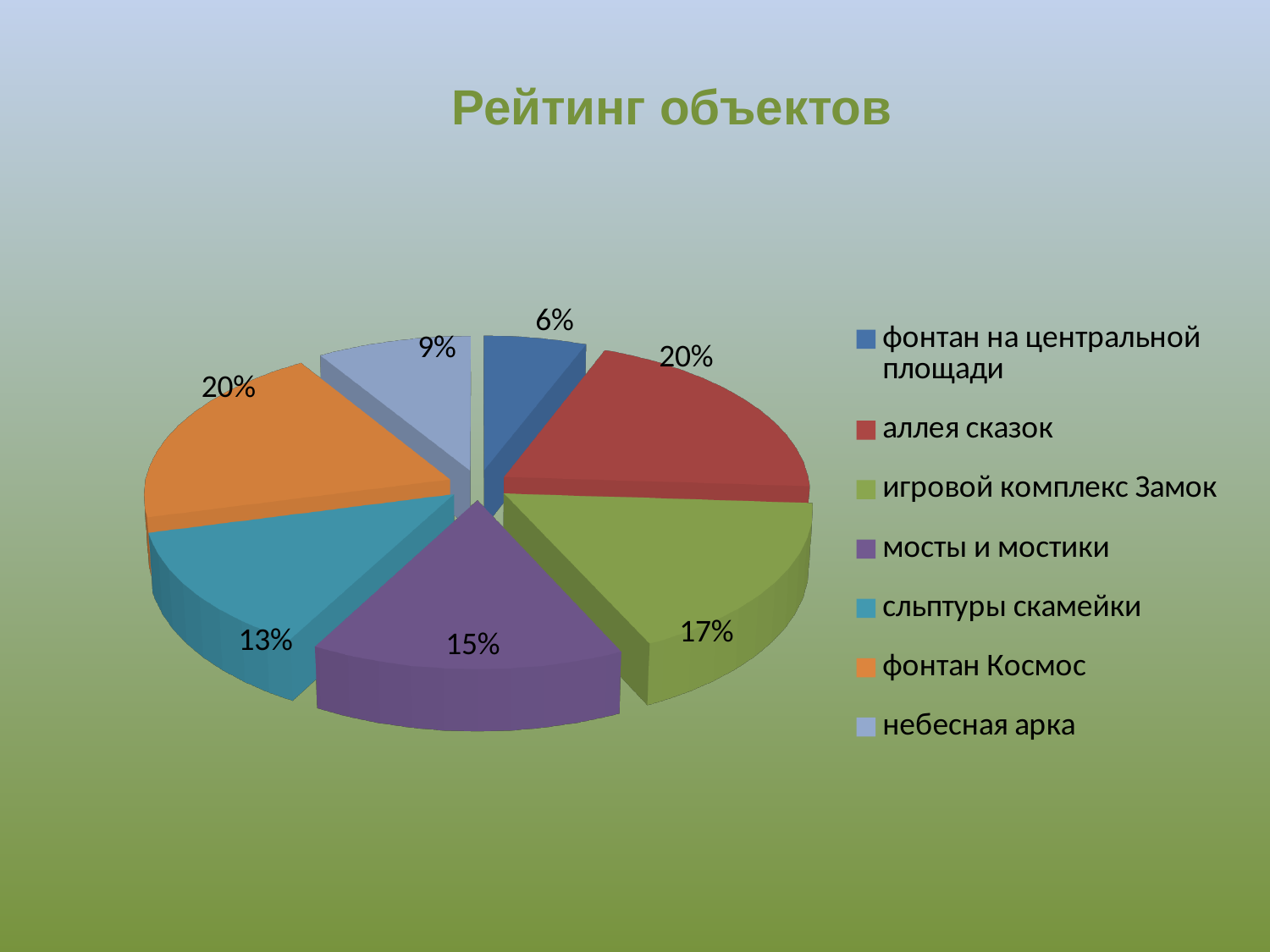
Which category has the smallest share of the pie? фонтан на центральной площади What share of the pie does "сльптуры скамейки" have? 13% What share of the pie does "мосты и мостики" have? 15% How many categories does the legend list? 7 What share of the pie does "аллея сказок" have? 20% What is the title of the chart? Рейтинг объектов What share of the pie does "игровой комплекс Замок" have? 17% Which two categories share the largest slice of the pie? аллея сказок and фонтан Космос What is the difference between the shares of "фонтан Космос" and "небесная арка"? 11% What type of chart is shown on the slide? pie chart What share of the pie does "небесная арка" have? 9% Which has a larger share: "игровой комплекс Замок" or "мосты и мостики"? игровой комплекс Замок